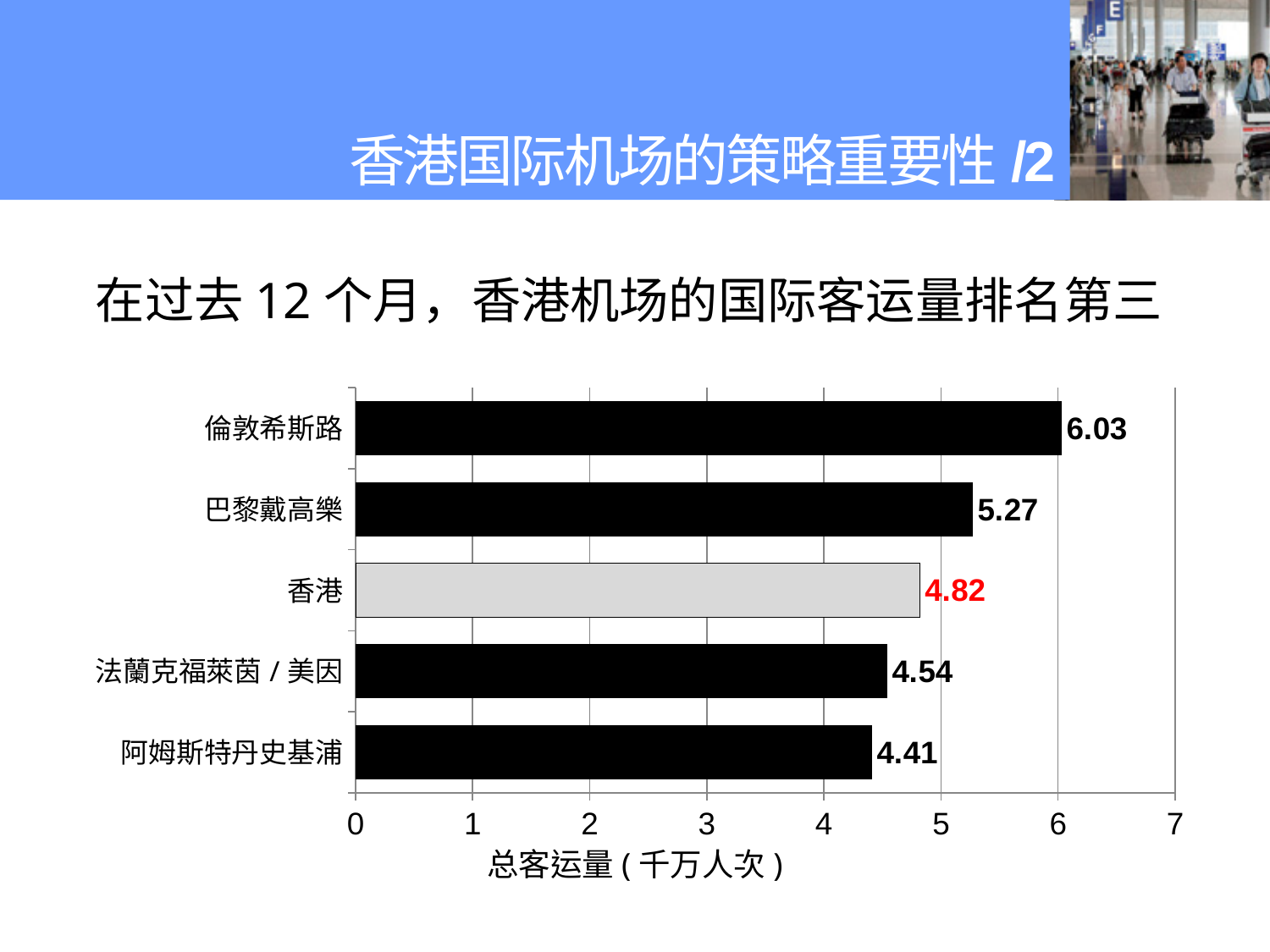
Which is larger, the value for 巴黎戴高樂 or the value for 香港? 巴黎戴高樂 Which airport has the lowest value? 阿姆斯特丹史基浦 What is the difference between the values for 巴黎戴高樂 and 阿姆斯特丹史基浦? 0.86 What kind of chart is shown on the slide? bar chart What is the value for 香港? 4.82 How many airports are shown in the chart? 5 What is the x-axis label of the chart? 总客运量 ( 千万人次 ) Which airport has the highest value? 倫敦希斯路 What is the value for 法蘭克福萊茵 / 美因? 4.54 What is the value for 阿姆斯特丹史基浦? 4.41 What is the value for 倫敦希斯路? 6.03 What is the difference between the values for 倫敦希斯路 and 香港? 1.21